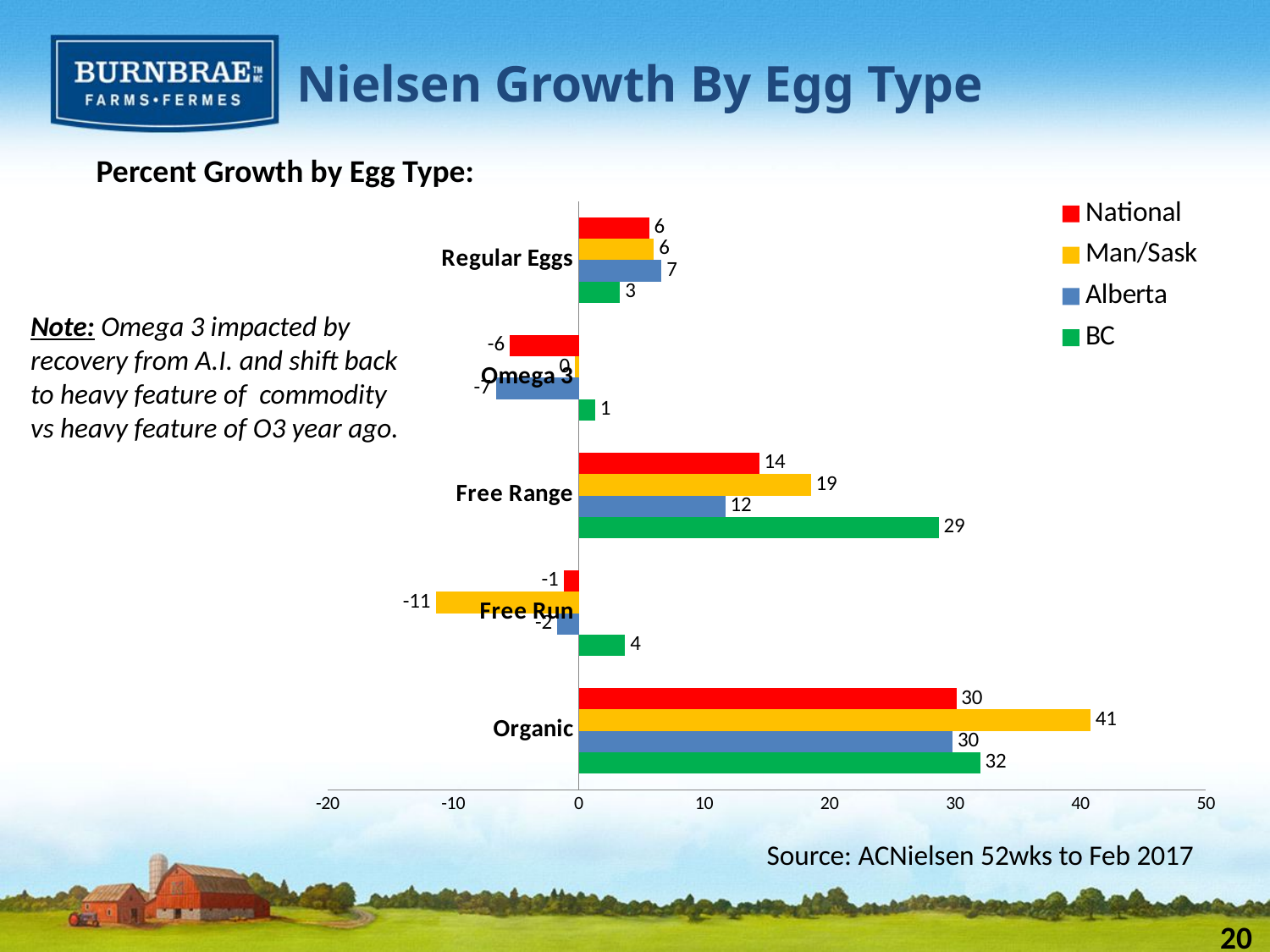
What is the National percent growth for Omega 3? -6 What is the difference between the Man/Sask and National percent growth for Organic? 11 How many series does the legend list? 4 Which egg type has the highest National percent growth? Organic What is the percent growth for Organic in Man/Sask? 41 What is the percent growth for Free Range in BC? 29 How many egg types are shown on the chart? 5 Which egg type has the lowest Man/Sask percent growth? Free Run What is the percent growth for Free Run in Man/Sask? -11 Which is larger for Free Range: the Man/Sask value or the Alberta value? Man/Sask What kind of chart is shown on the slide? Bar chart Which colour represents BC in the chart? Green